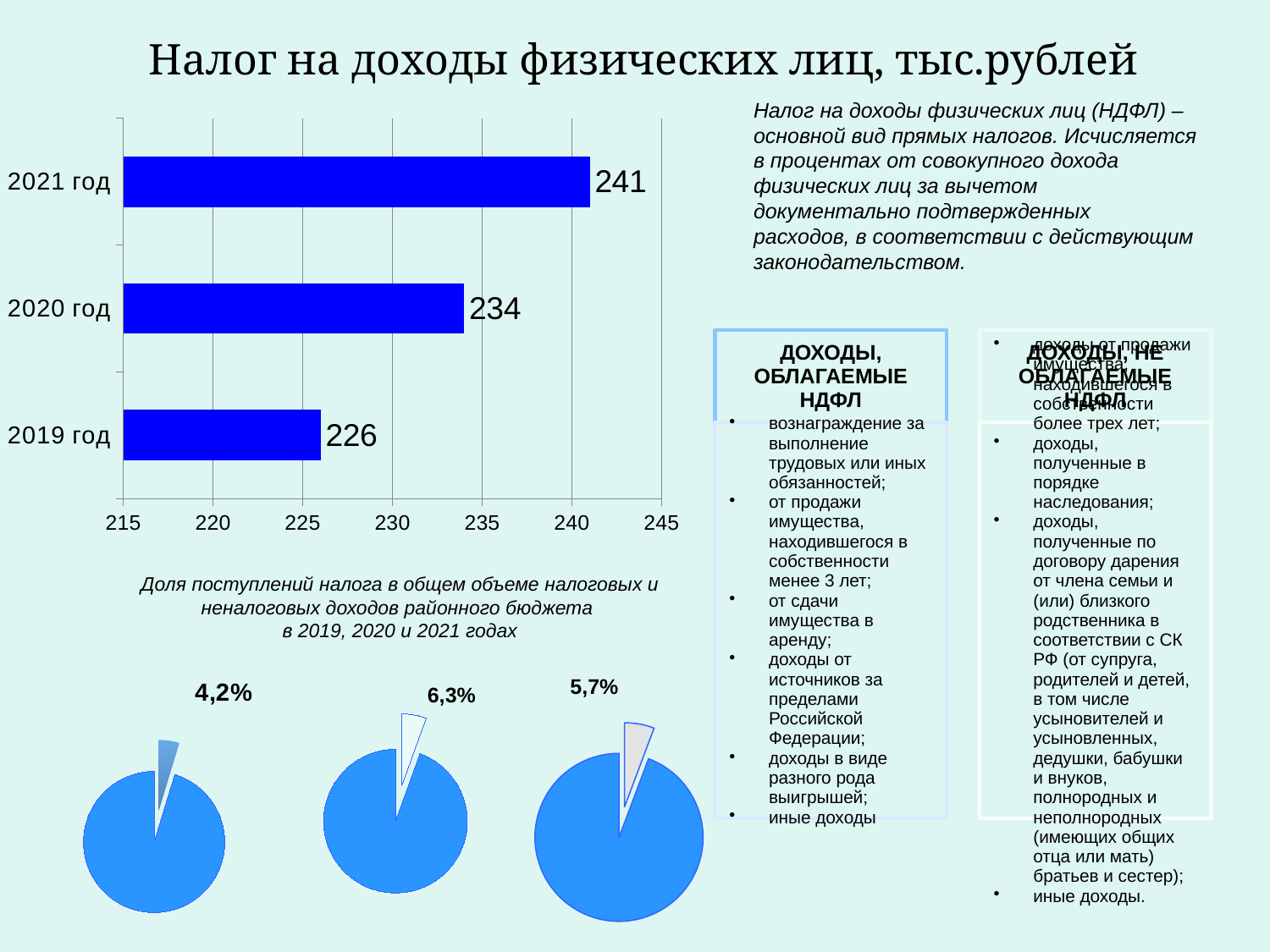
What kind of chart is the chart at the top left of the slide? bar chart In the bar chart, what is the value for 2021 год? 241 In the bar chart, what is the value for 2019 год? 226 In the bar chart, which is larger, the value for 2020 год or 2019 год? 2020 год In the bar chart, is the value for 2021 год greater or less than 240? greater In the bar chart, which year has the lowest value? 2019 год In the bar chart, which year has the highest value? 2021 год In the bar chart, what is the difference between the values for 2021 год and 2019 год? 15 In the bar chart, what is the value for 2020 год? 234 What share is labelled on the middle pie chart at the bottom of the slide? 6,3% How many bars does the bar chart show? 3 In the bar chart, do the values rise or fall from 2019 год to 2021 год? rise